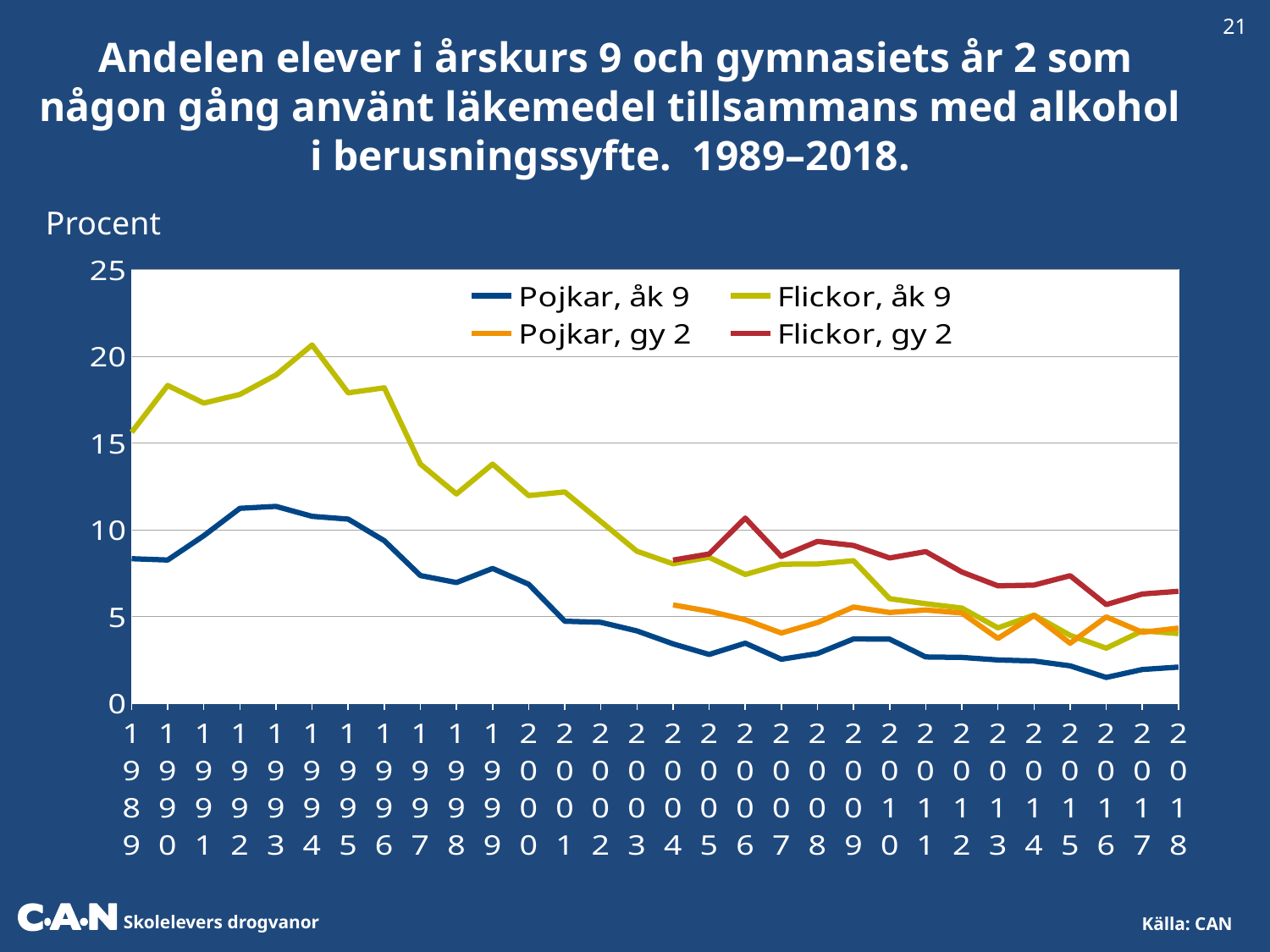
How many series does the legend list? 4 How many years are plotted along the x axis? 30 Does the Pojkar, åk 9 series rise or fall from 1993 to 2018? Fall Which series is drawn in orange? Pojkar, gy 2 Which series has the highest value in 1994? Flickor, åk 9 What is the label on the y axis? Procent Which series has the lowest value in 2016? Pojkar, åk 9 In 2010, which is larger: the value for Flickor, gy 2 or the value for Pojkar, gy 2? Flickor, gy 2 Is the value for Flickor, åk 9 in 1997 greater or less than 15? less Is the value for Pojkar, åk 9 in 2016 greater or less than 5? less What kind of chart is shown on the slide? Line chart Is the value for Pojkar, åk 9 in 1992 greater or less than 10? greater